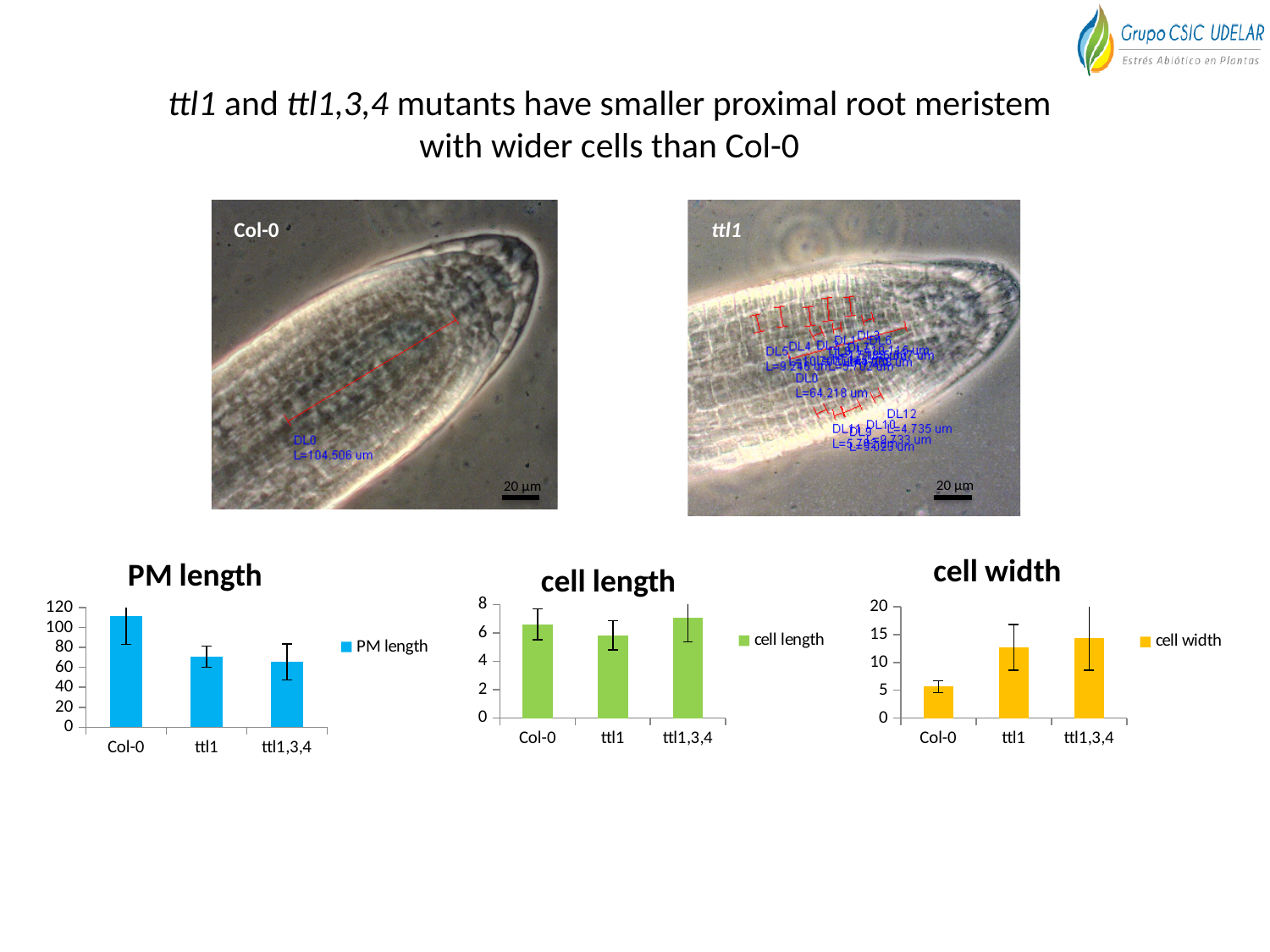
In the "cell length" chart, is the value for ttl1,3,4 greater or less than 6? greater In the "cell width" chart, which category has the lowest value? Col-0 What kind of chart is the "PM length" chart? bar chart In the "PM length" chart, is the value for ttl1 greater or less than 80? less How many series does the legend of the "cell width" chart list? 1 How many categories are shown on the x axis of the "cell length" chart? 3 In the "cell width" chart, which is larger, the value for Col-0 or the value for ttl1? ttl1 In the "PM length" chart, is the value for Col-0 greater or less than 100? greater In the "PM length" chart, which category has the highest value? Col-0 What colour are the bars in the "cell length" chart? green